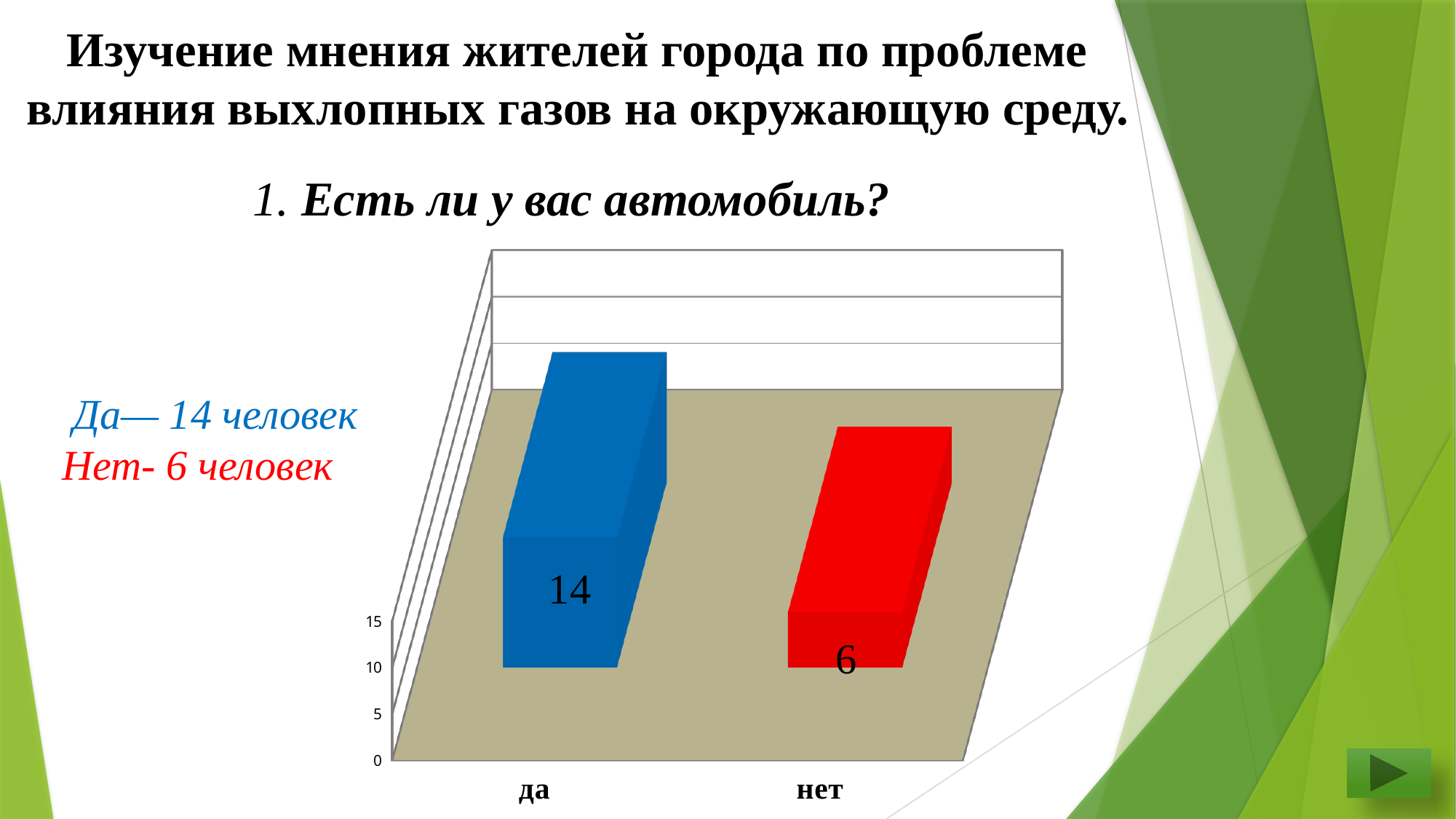
What is the value for "да"? 14 How many categories are shown on the chart? 2 What colour is the bar for "нет"? red Is the value for "нет" greater or less than 10? less Is the value for "да" greater or less than 10? greater Which category has the highest value? да Which category has the lowest value? нет Which is larger, the value for "да" or the value for "нет"? да What is the total of the two bars on the chart? 20 What is the value for "нет"? 6 What kind of chart is shown on the slide? bar chart What is the difference between the values for "да" and "нет"? 8